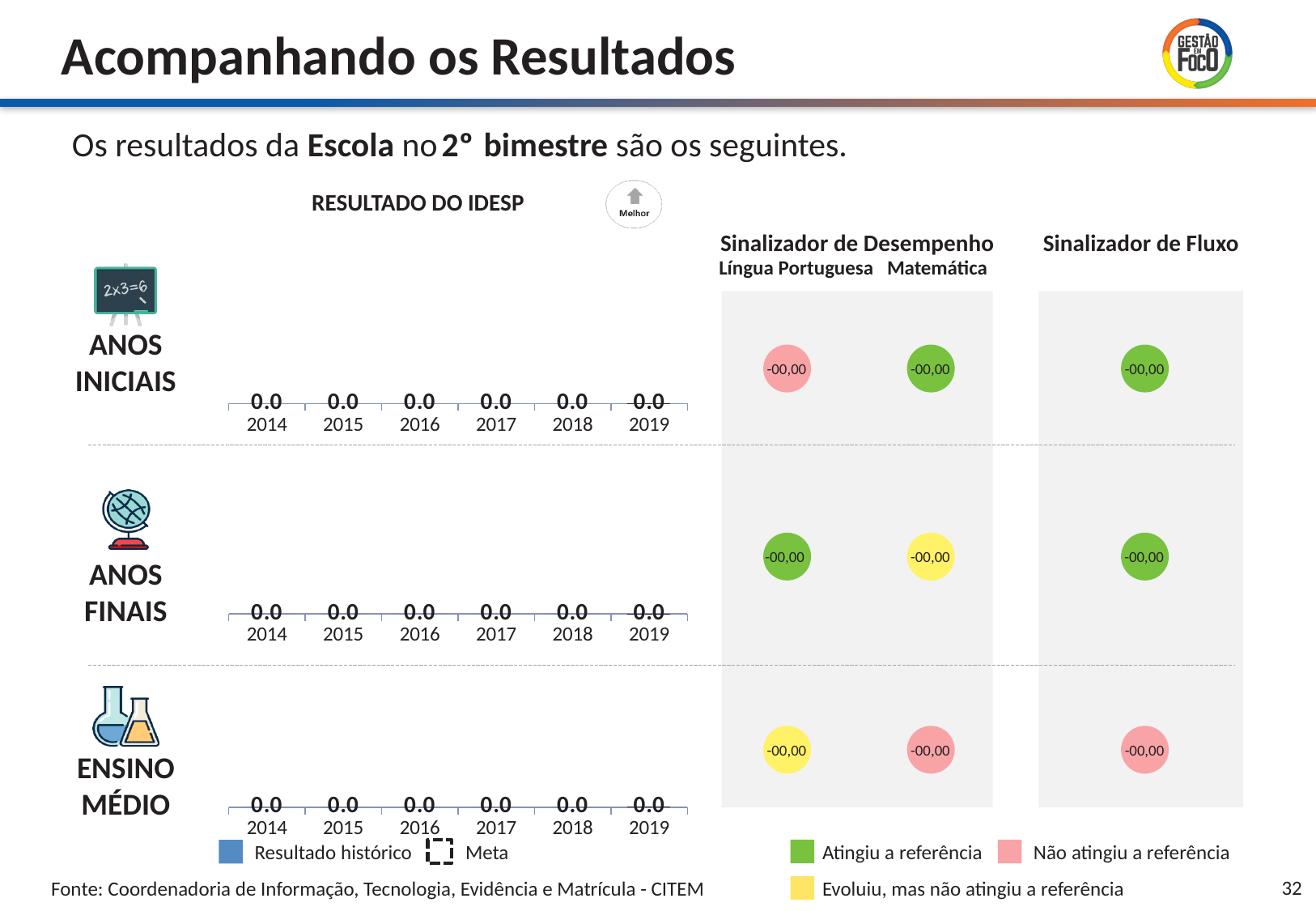
In the ENSINO MÉDIO chart, what is the value shown for 2017? 0.0 What is the difference between the 2018 and 2019 values in the ANOS FINAIS chart? 0.0 Do the values in the ENSINO MÉDIO chart rise, fall, or stay flat from 2014 to 2019? stay flat What is the title shown above the three charts on the left of the slide? RESULTADO DO IDESP In the ANOS FINAIS chart, what is the value shown for 2019? 0.0 How many years are plotted along the x axis of the ANOS INICIAIS chart? 6 How many years are plotted along the x axis of the ENSINO MÉDIO chart? 6 In the ANOS INICIAIS chart, what is the value shown for 2014? 0.0 How many series does the legend below the ENSINO MÉDIO chart list? 2 Do the values in the ANOS INICIAIS chart rise, fall, or stay flat from 2014 to 2019? stay flat What is the total of the 2014 values across the ANOS INICIAIS, ANOS FINAIS and ENSINO MÉDIO charts? 0.0 What is the first year shown on the x axis of the ANOS FINAIS chart? 2014